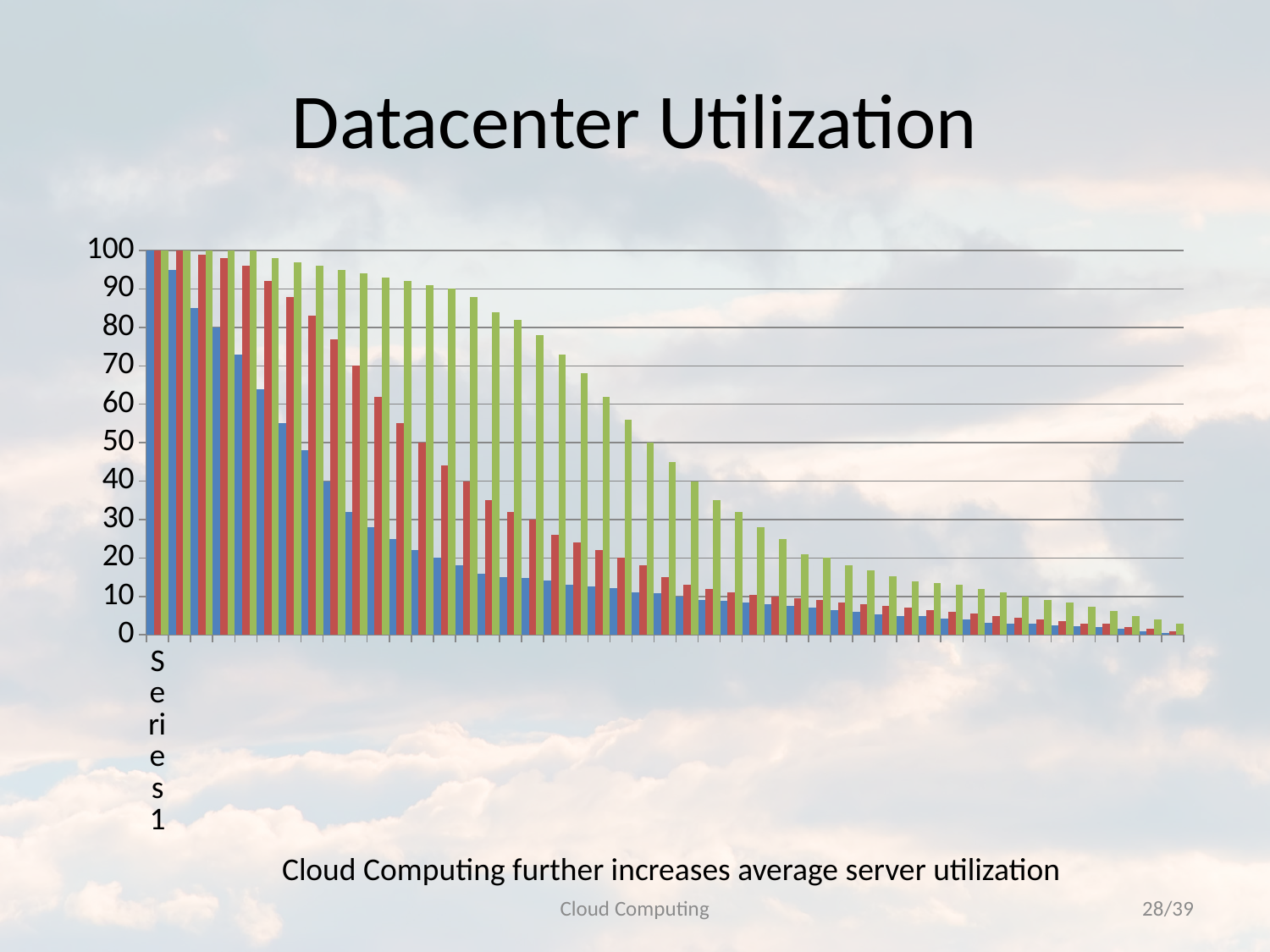
Is the blue bar for the first category (Series 1) greater or less than 90? greater Which coloured series has the larger value in the rightmost category, blue or green? green Is the green bar for the rightmost category greater or less than 10? less What is the title of the chart? Datacenter Utilization What kind of chart is shown on the slide? bar chart What is the highest value shown on the vertical axis? 100 How many differently coloured bar series are plotted in the chart? 3 Do the bar values rise or fall moving from left to right along the x axis? fall Which coloured series keeps the highest values across most of the categories in the middle of the chart? green Is the red bar for the first category (Series 1) greater or less than 50? greater